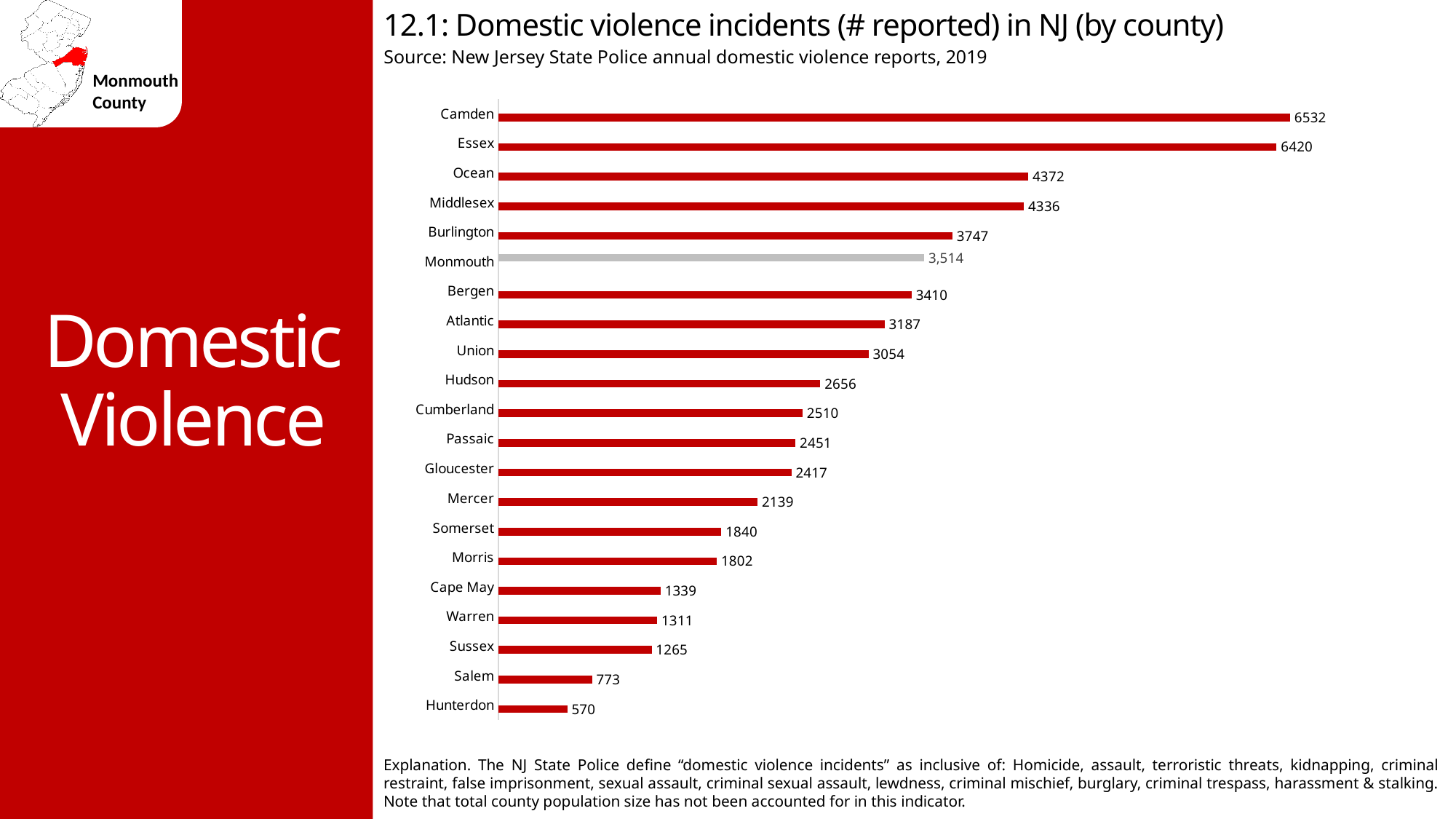
How many domestic violence incidents were reported in Monmouth County? 3,514 Which county reported more domestic violence incidents, Salem or Sussex? Sussex How many counties are shown in the chart? 21 Which county has the lowest number of reported domestic violence incidents? Hunterdon How many domestic violence incidents were reported in Hunterdon County? 570 What is the difference in reported incidents between Camden and Essex? 112 What is the difference in reported incidents between Burlington and Monmouth? 233 How many domestic violence incidents were reported in Camden County? 6532 Which county has the highest number of reported domestic violence incidents? Camden Which county's bar is shown in grey rather than red? Monmouth What type of chart is used to show domestic violence incidents by county? Bar chart Which county reported more domestic violence incidents, Ocean or Middlesex? Ocean